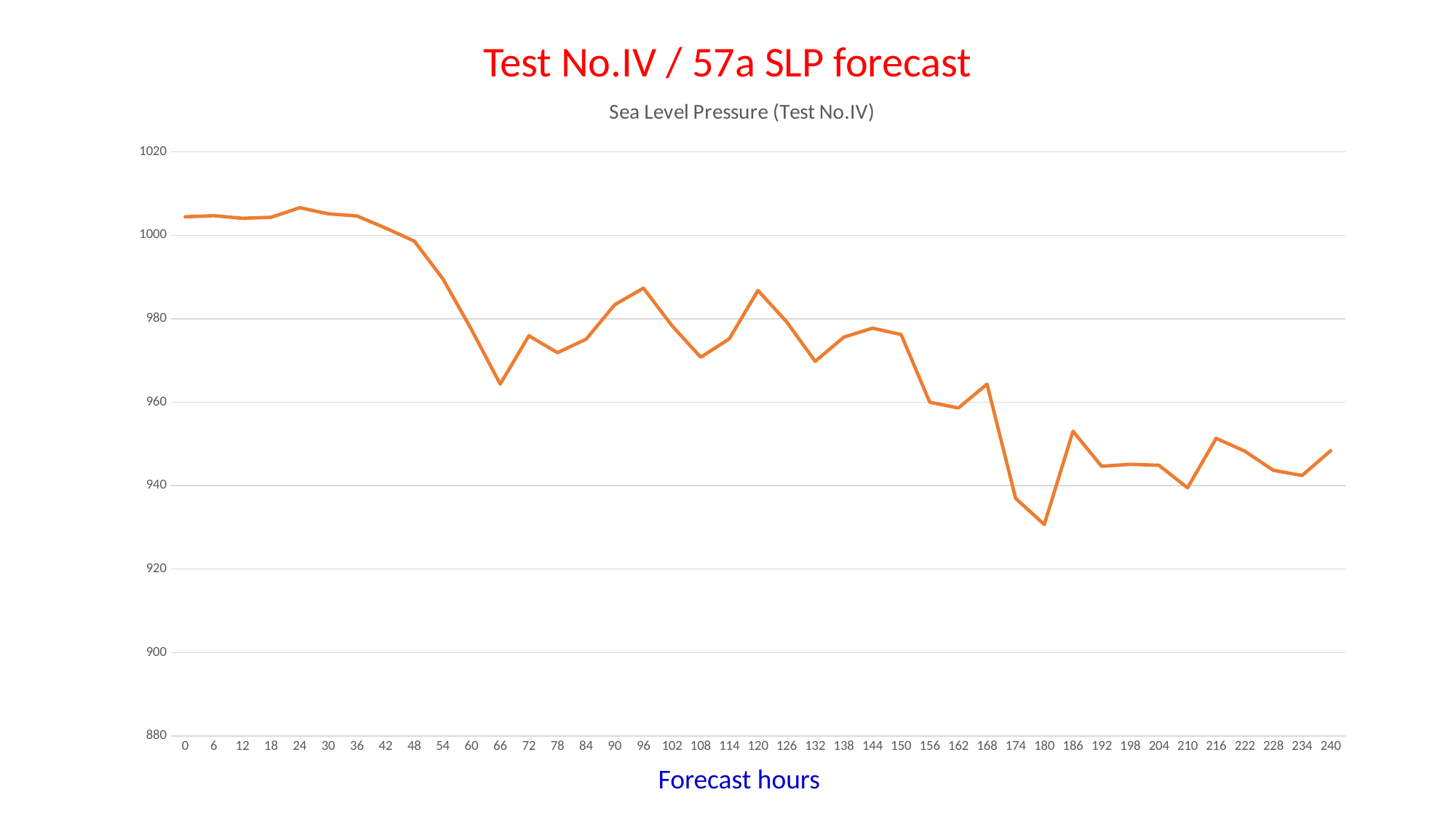
Is the value at forecast hour 240 greater or less than 960? less Is the value at forecast hour 180 greater or less than 940? less At which forecast hour is the sea level pressure lowest? 180 Is the value at forecast hour 0 greater or less than 1000? greater What is the title printed above the chart area? Sea Level Pressure (Test No.IV) How many forecast-hour points are plotted along the x axis? 41 What is the label of the x axis? Forecast hours Which has the higher sea level pressure, forecast hour 48 or forecast hour 168? 48 What kind of chart is shown on the slide? line chart Overall, do the sea level pressure values rise or fall from forecast hour 0 to 240? fall